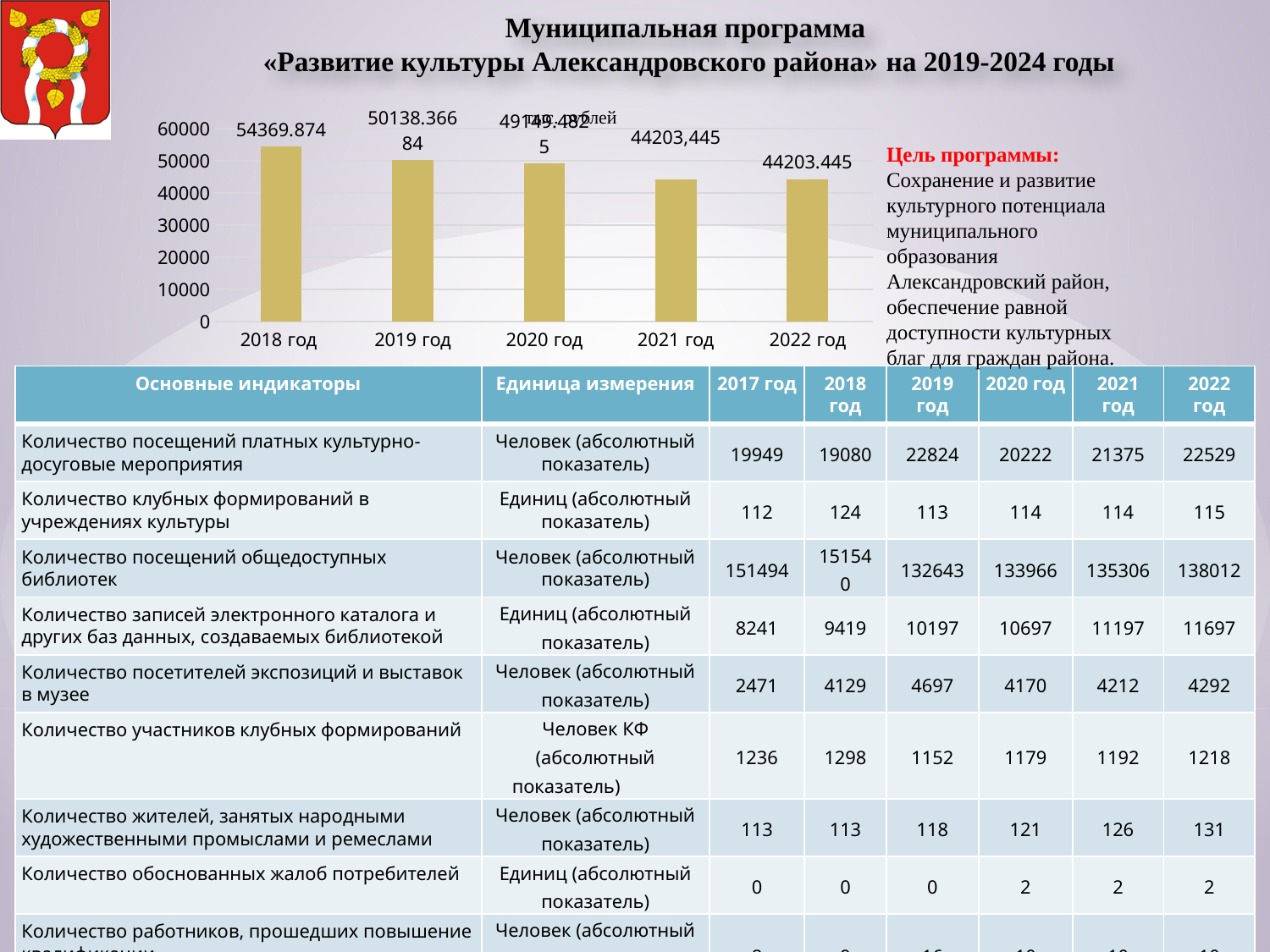
Is the value for 2021 год in the bar chart greater or less than 50000? less What colour are the bars in the chart? gold (yellow) How many bars (years) are shown in the chart? 5 Which is larger in the bar chart, the value for 2018 год or the value for 2022 год? 2018 год Which year has the highest bar in the chart? 2018 год Do the values in the bar chart generally rise or fall from 2018 год to 2022 год? fall What type of chart is shown on the slide? bar chart What is the value shown for 2018 год in the bar chart? 54369.874 What is the value shown for 2021 год in the bar chart? 44203,445 What is the difference between the values for 2018 год and 2022 год in the bar chart? 10166.429 What is the value shown for 2022 год in the bar chart? 44203.445 Is the value for 2020 год in the bar chart greater or less than 40000? greater